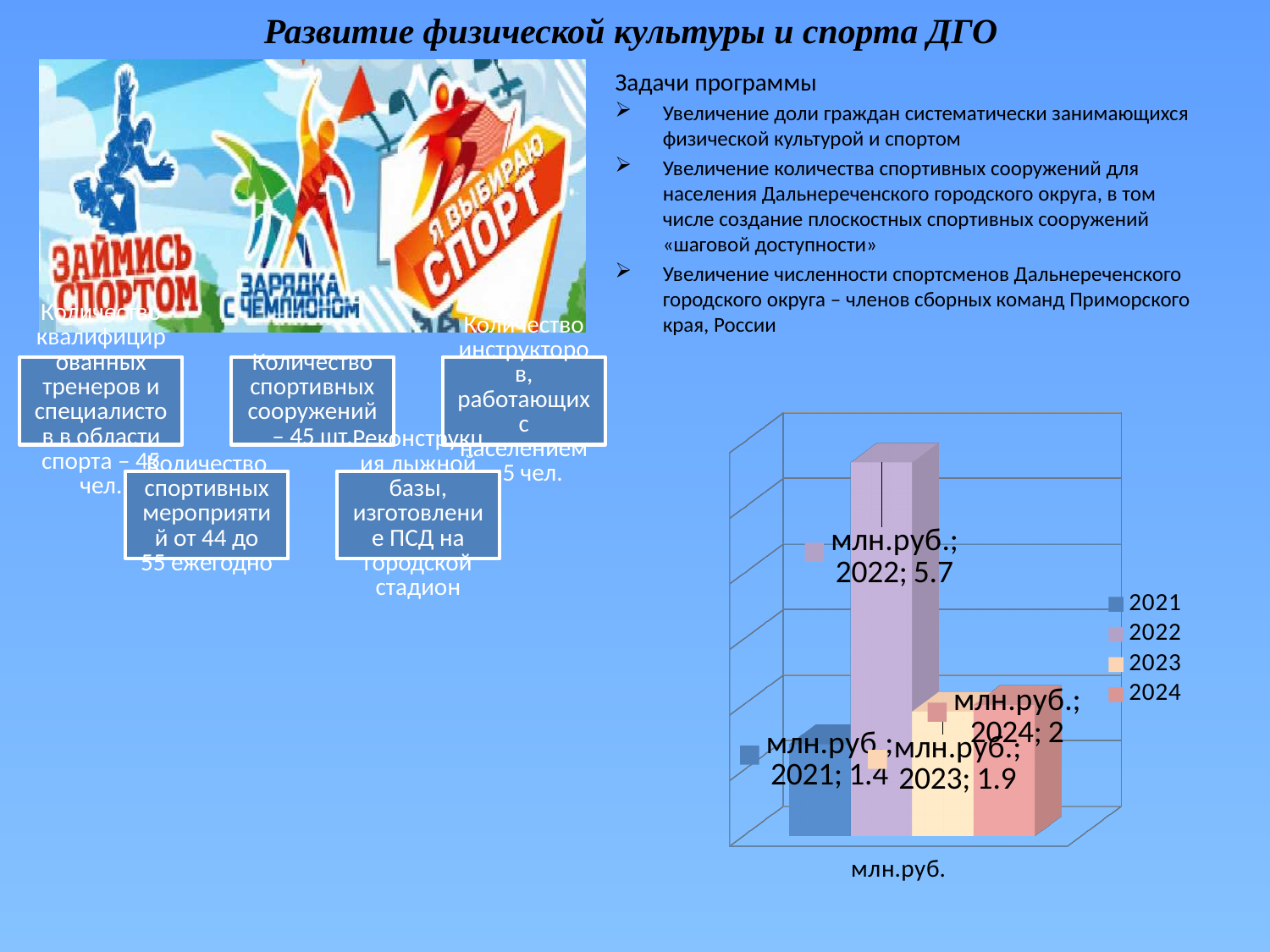
What kind of chart is shown on the slide? bar chart What is the category label shown below the chart's bars? млн.руб. What is the value for 2021 in the chart? 1.4 Which is larger, the value for 2023 or the value for 2021? 2023 What is the value for 2024 in the chart? 2 What is the difference between the values for 2022 and 2021? 4.3 What is the value for 2023 in the chart? 1.9 What is the difference between the values for 2024 and 2023? 0.1 Which year has the lowest value in the chart? 2021 How many series does the chart legend list? 4 Which year has the highest value in the chart? 2022 What is the value for 2022 in the chart? 5.7